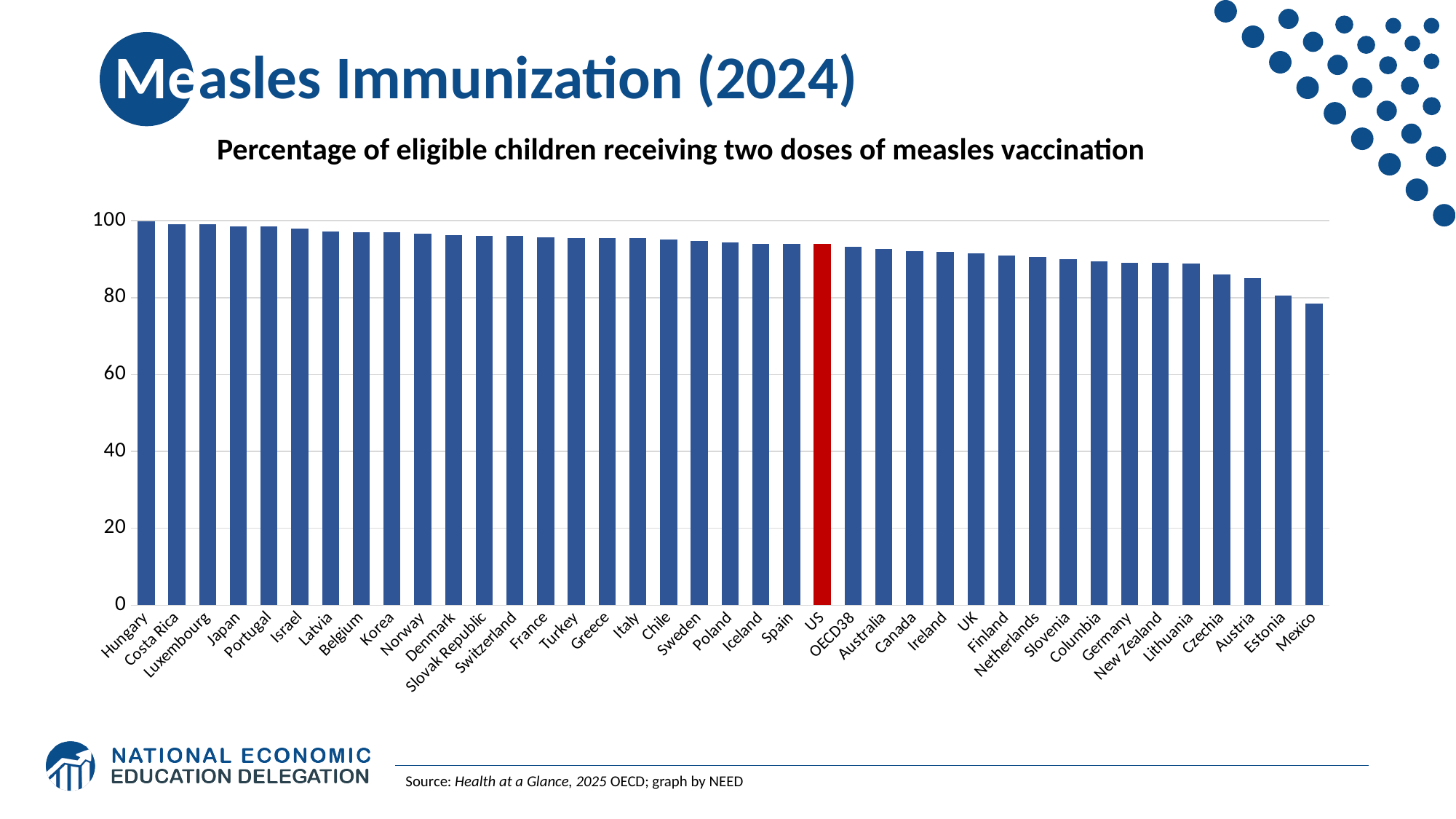
Is the value for US greater or less than 80? greater How many countries/categories are plotted on the chart? 39 Which category has the lowest bar on the chart? Mexico Which has a larger value, Estonia or Japan? Japan Do the values generally rise or fall moving from left to right along the x axis? Fall Is the value for Austria greater or less than 80? greater Which category has the highest bar on the chart? Hungary Is the value for Germany greater or less than 100? less What kind of chart is shown on the slide? Bar chart Which category's bar is highlighted in red? US Which has a larger value, Hungary or Mexico? Hungary